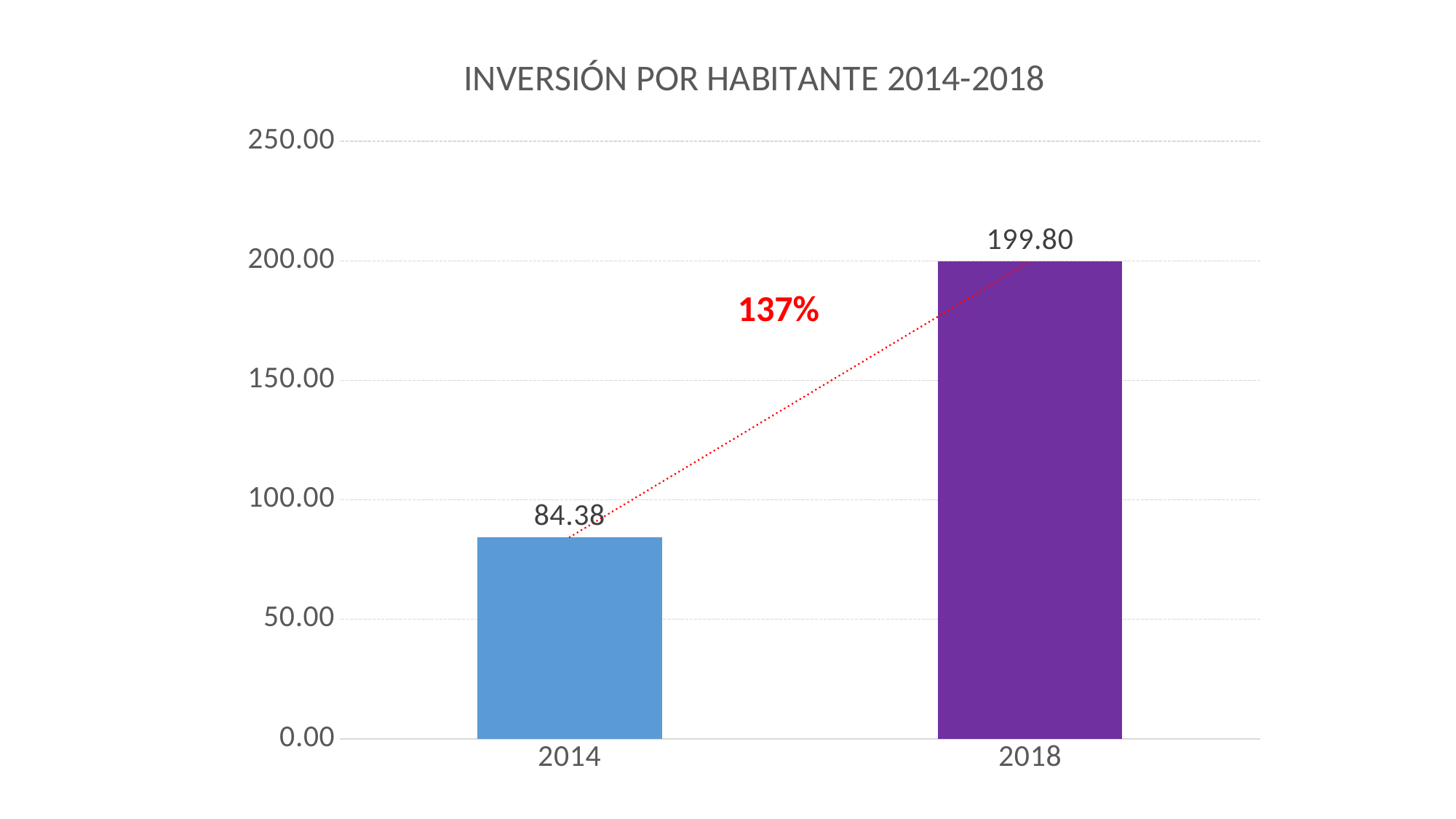
Do the values rise or fall from 2014 to 2018? rise Which is larger, the value for 2014 or the value for 2018? 2018 What is the value for 2018? 199.80 How many bars are shown in the chart? 2 Which year has the highest value? 2018 What is the value for 2014? 84.38 What is the title of the chart? INVERSIÓN POR HABITANTE 2014-2018 Is the value for 2018 greater or less than 150.00? greater Is the value for 2014 greater or less than 100.00? less What kind of chart is shown on the slide? bar chart What is the difference between the values for 2018 and 2014? 115.42 Which year has the lowest value? 2014